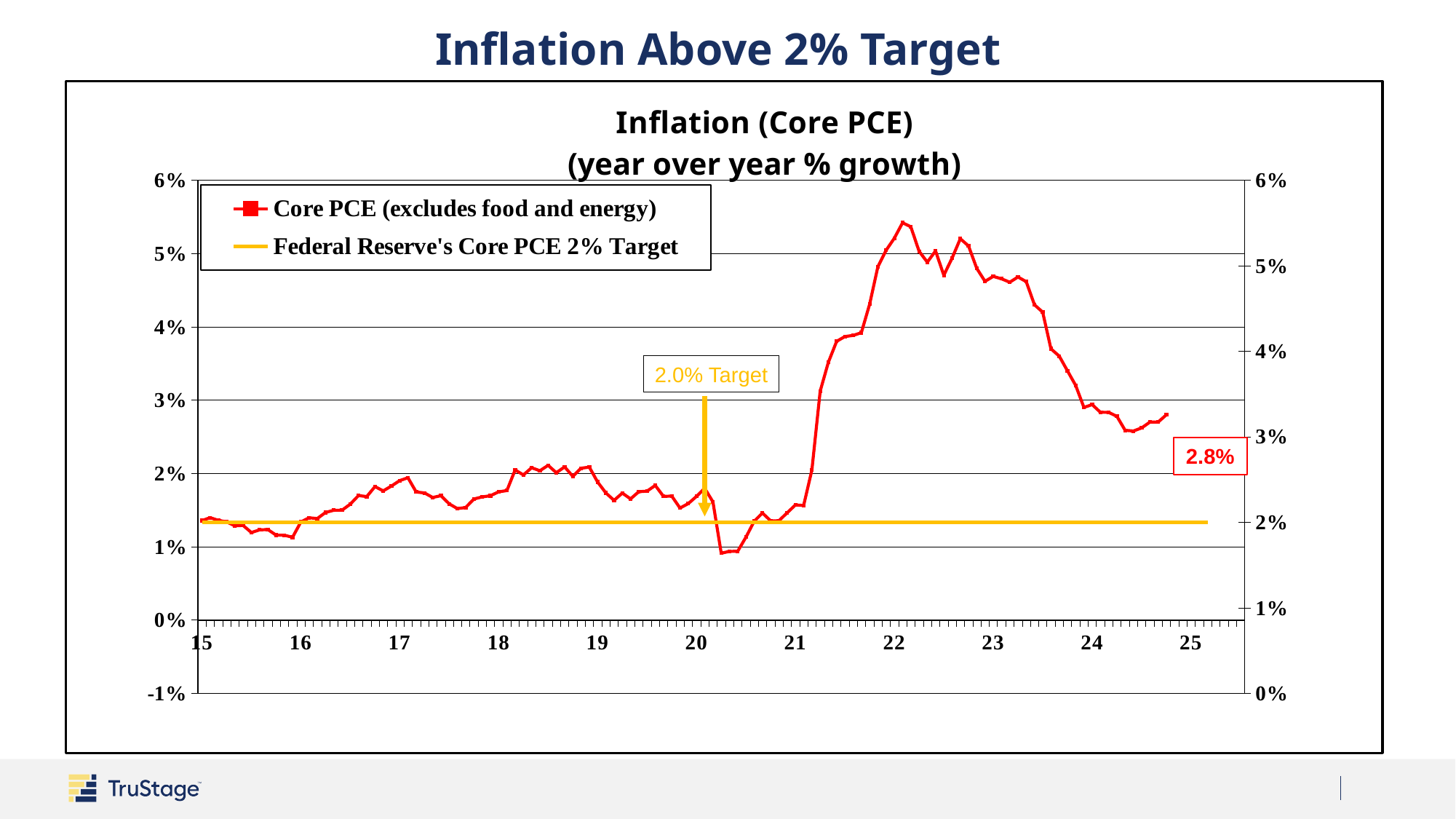
What is the title of the chart? Inflation (Core PCE) (year over year % growth) What kind of chart is shown on the slide? line chart Is the peak Core PCE value around 2022 greater or less than 4%? greater What is the Federal Reserve's Core PCE target shown on the chart? 2.0% What is the most recent Core PCE value labeled on the chart? 2.8% Is the lowest Core PCE value in 2020 greater or less than 2%? less Do Core PCE values rise or fall between 2022 and 2024? fall Around which year does Core PCE reach its highest value? 22 Which series is drawn in red according to the legend? Core PCE (excludes food and energy) Do Core PCE values rise or fall between 2021 and 2022? rise Which is larger, the latest Core PCE value or the Federal Reserve's 2% target? the latest Core PCE value How many series does the legend list? 2